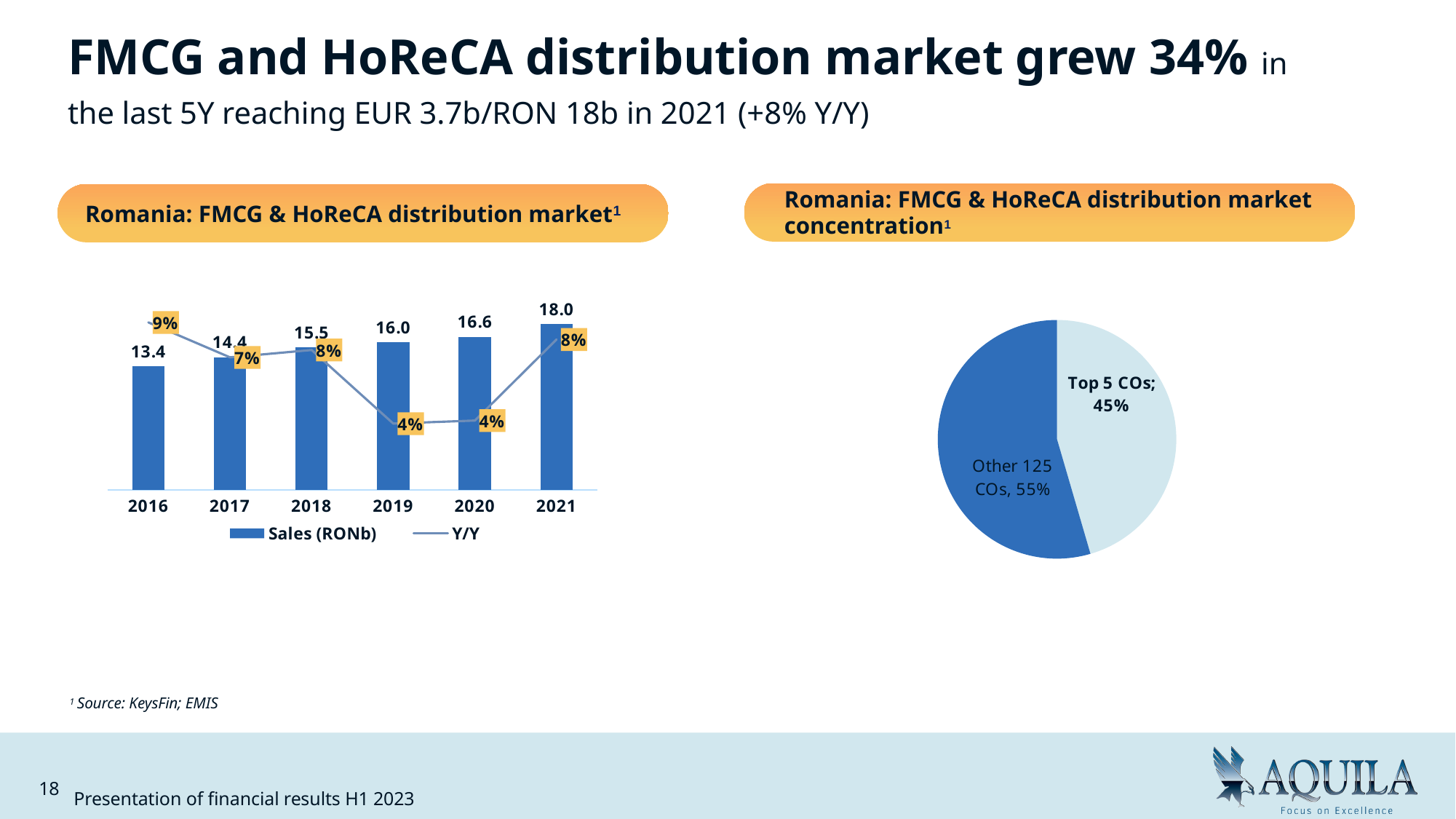
What type of chart is the 'Romania: FMCG & HoReCA distribution market concentration' chart? pie chart In the 'Romania: FMCG & HoReCA distribution market' chart, which year has the highest Sales (RONb)? 2021 How many series does the legend of the 'Romania: FMCG & HoReCA distribution market' chart list? 2 In the 'Romania: FMCG & HoReCA distribution market' chart, which year has the lowest Sales (RONb)? 2016 Do the Sales (RONb) values in the 'Romania: FMCG & HoReCA distribution market' chart rise or fall from 2016 to 2021? rise In the 'Romania: FMCG & HoReCA distribution market' chart, what is the Y/Y growth shown for 2016? 9% In the 'Romania: FMCG & HoReCA distribution market' chart, what is the difference in Sales (RONb) between 2021 and 2016? 4.6 In the 'Romania: FMCG & HoReCA distribution market' chart, is the Y/Y growth higher in 2017 or in 2019? 2017 How many years are shown on the x axis of the 'Romania: FMCG & HoReCA distribution market' chart? 6 In the 'Romania: FMCG & HoReCA distribution market concentration' chart, what is the label of the larger slice? Other 125 COs, 55% In the 'Romania: FMCG & HoReCA distribution market' chart, what is the Sales (RONb) value for 2019? 16.0 In the 'Romania: FMCG & HoReCA distribution market concentration' chart, what share of the market do the Top 5 COs hold? 45%